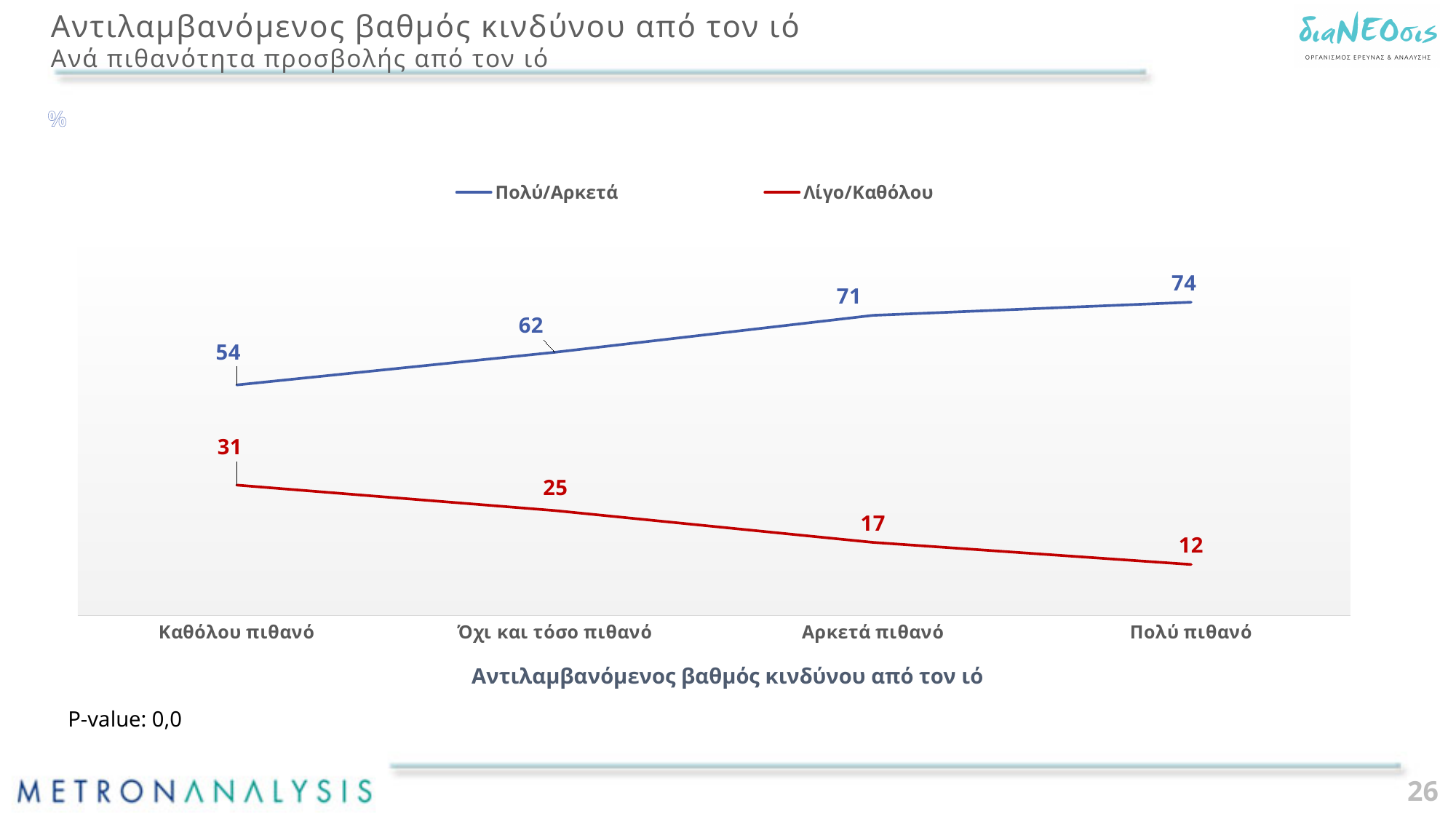
Does the Λίγο/Καθόλου series rise or fall from Καθόλου πιθανό to Πολύ πιθανό? Fall What kind of chart is shown on the slide? Line chart For which category is the Πολύ/Αρκετά series highest? Πολύ πιθανό What is the value of the Πολύ/Αρκετά series for Αρκετά πιθανό? 71 What is the value of the Πολύ/Αρκετά series for Καθόλου πιθανό? 54 What is the difference between the Πολύ/Αρκετά and Λίγο/Καθόλου values for Καθόλου πιθανό? 23 How many series does the legend list? 2 What is the value of the Λίγο/Καθόλου series for Πολύ πιθανό? 12 For which category is the Λίγο/Καθόλου series lowest? Πολύ πιθανό Which series has the larger value for Αρκετά πιθανό, Πολύ/Αρκετά or Λίγο/Καθόλου? Πολύ/Αρκετά How many categories are shown on the x axis? 4 What is the value of the Λίγο/Καθόλου series for Όχι και τόσο πιθανό? 25